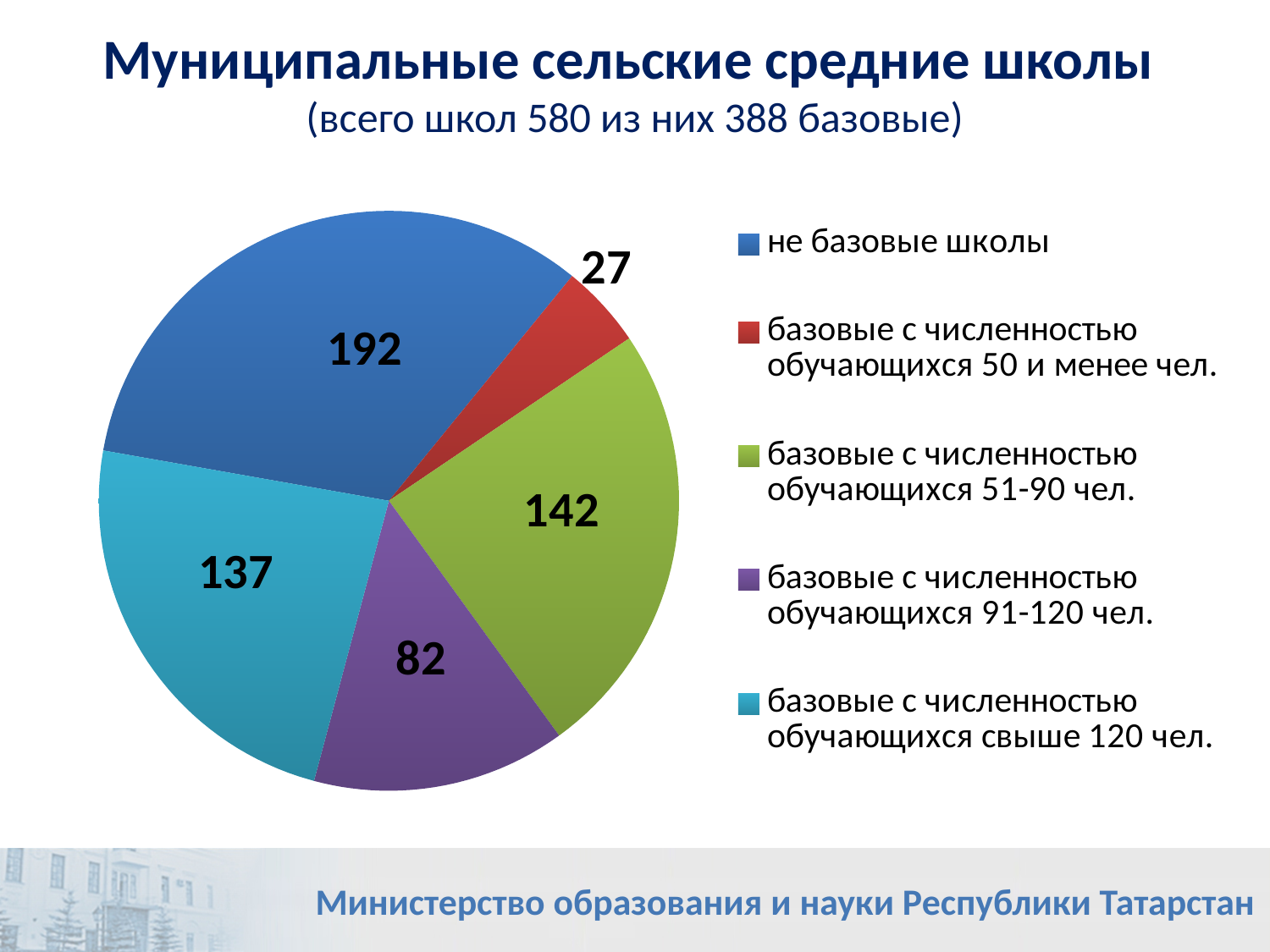
What is the value for "базовые с численностью обучающихся свыше 120 чел."? 137 Which category has the largest slice? не базовые школы What is the difference between the value for "не базовые школы" and the value for "базовые с численностью обучающихся свыше 120 чел."? 55 What is the value for "базовые с численностью обучающихся 91-120 чел."? 82 How many slices does the pie chart have? 5 What type of chart is shown on the slide? pie chart What is the value for "базовые с численностью обучающихся 50 и менее чел."? 27 What is the value for "базовые с численностью обучающихся 51-90 чел."? 142 Which is larger: the value for "базовые с численностью обучающихся 51-90 чел." or the value for "базовые с численностью обучающихся 91-120 чел."? базовые с численностью обучающихся 51-90 чел. Which category has the smallest slice? базовые с численностью обучающихся 50 и менее чел. How many entries does the legend list? 5 What is the value for "не базовые школы"? 192